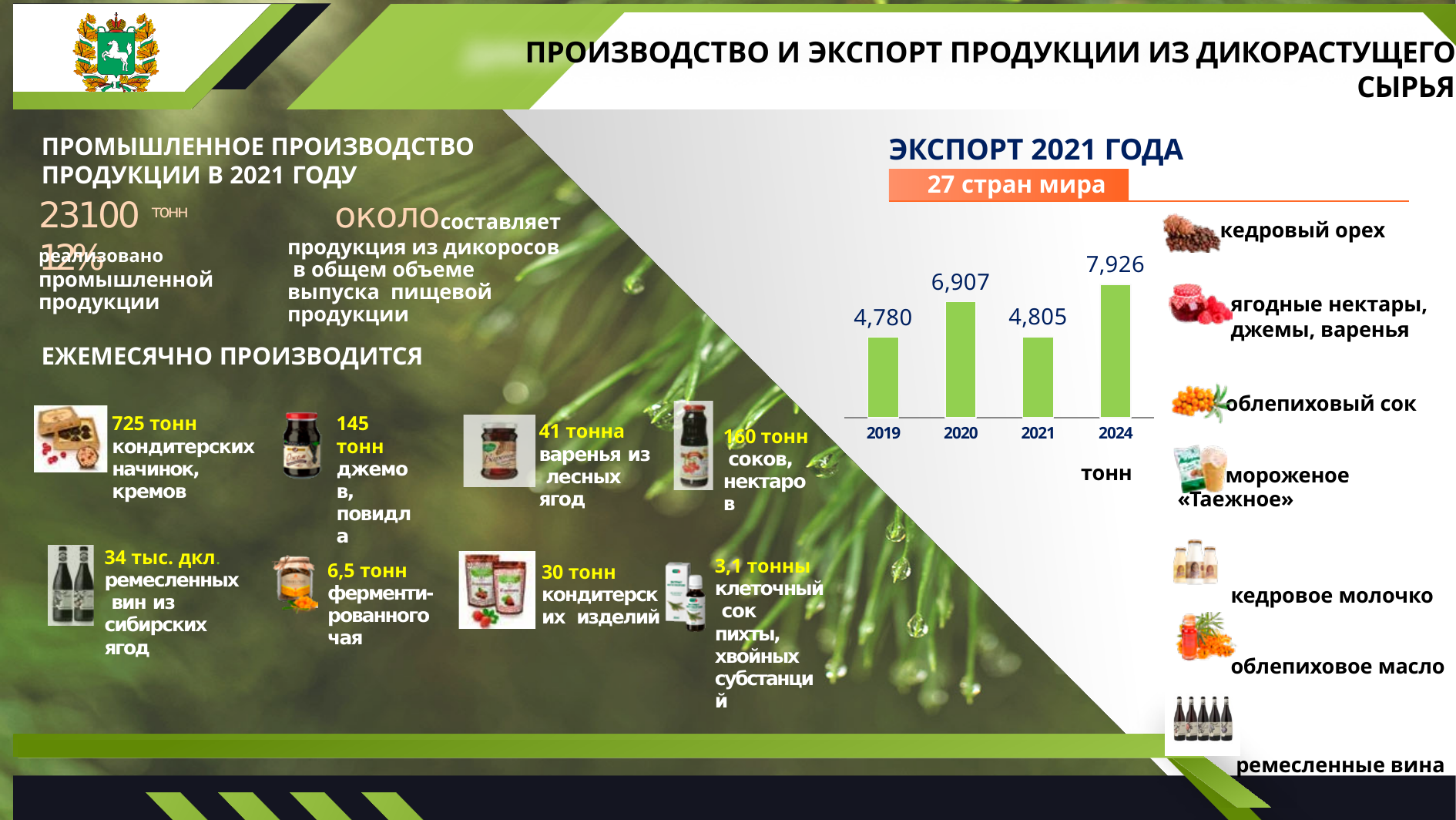
What is the value for 2021 on the bar chart? 4,805 What kind of chart is shown on the slide? bar chart What is the value for 2024 on the bar chart? 7,926 What is the value for 2019 on the bar chart? 4,780 Which year has the highest value on the bar chart? 2024 Which is larger on the bar chart, the value for 2020 or the value for 2021? 2020 What unit is indicated below the bar chart? тонн What is the difference between the values for 2024 and 2020 on the bar chart? 1,019 What is the value for 2020 on the bar chart? 6,907 What is the difference between the values for 2020 and 2019 on the bar chart? 2,127 How many years are shown on the bar chart? 4 Which year has the lowest value on the bar chart? 2019